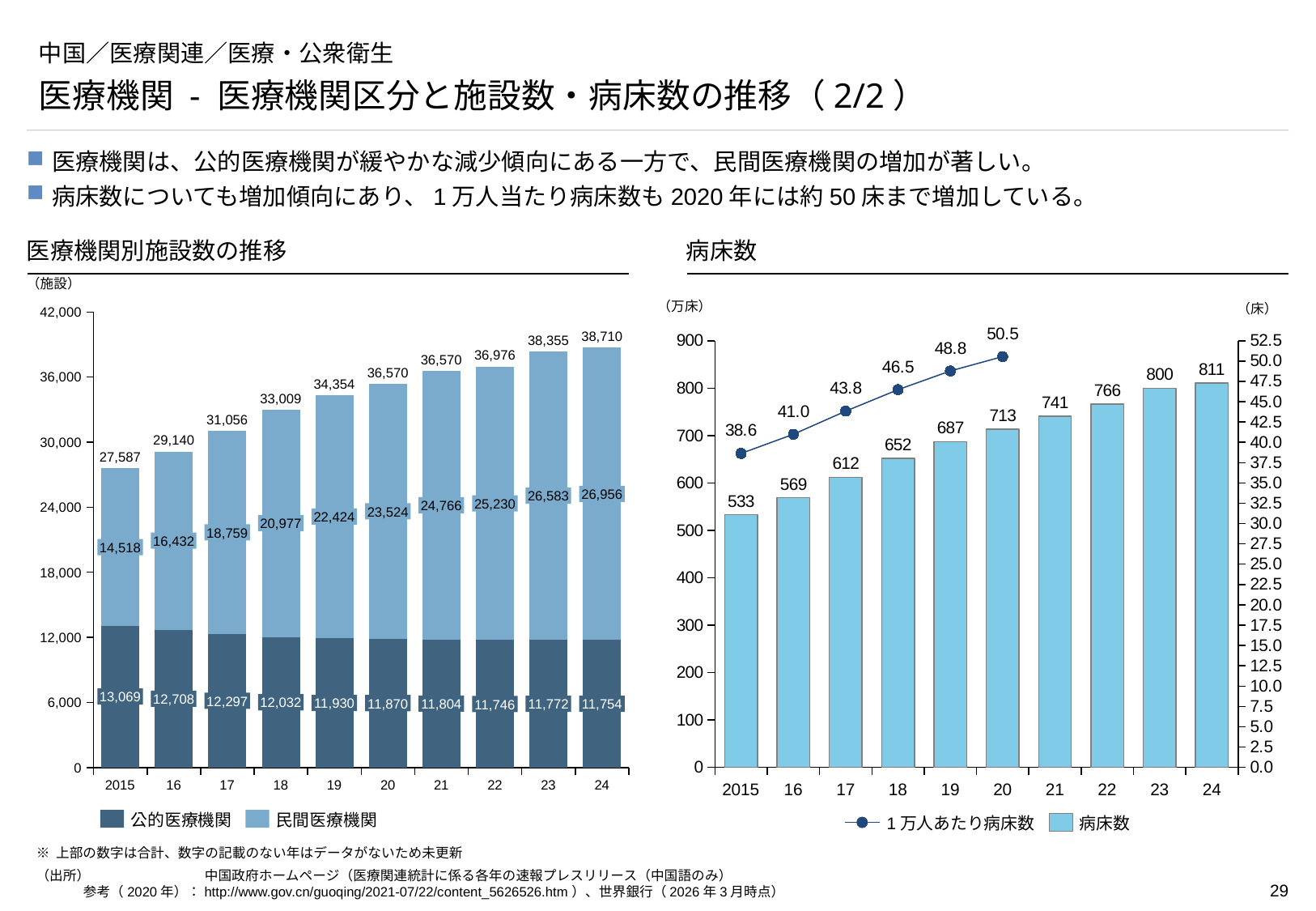
In the 医療機関別施設数の推移 chart, what is the difference between the 民間医療機関 values for 24 and 2015? 12,438 In the 医療機関別施設数の推移 chart, how many series does the legend list? 2 In the 医療機関別施設数の推移 chart, does the value for 民間医療機関 rise or fall from 2015 to 24? rise In the 病床数 chart, how many years are shown on the x axis? 10 In the 医療機関別施設数の推移 chart, what is the value for 民間医療機関 in 24? 26,956 In the 病床数 chart, what is the difference between the 病床数 values for 24 and 23? 11 In the 病床数 chart, which year has the lowest value for 病床数? 2015 In the 病床数 chart, what is the value for 1万人あたり病床数 in 20? 50.5 In the 医療機関別施設数の推移 chart, what is the total shown above the bar for 18? 33,009 In the 病床数 chart, what is the value for 病床数 in 19? 687 In the 医療機関別施設数の推移 chart, which year has the highest value for 公的医療機関? 2015 In the 医療機関別施設数の推移 chart, what is the value for 公的医療機関 in 2015? 13,069